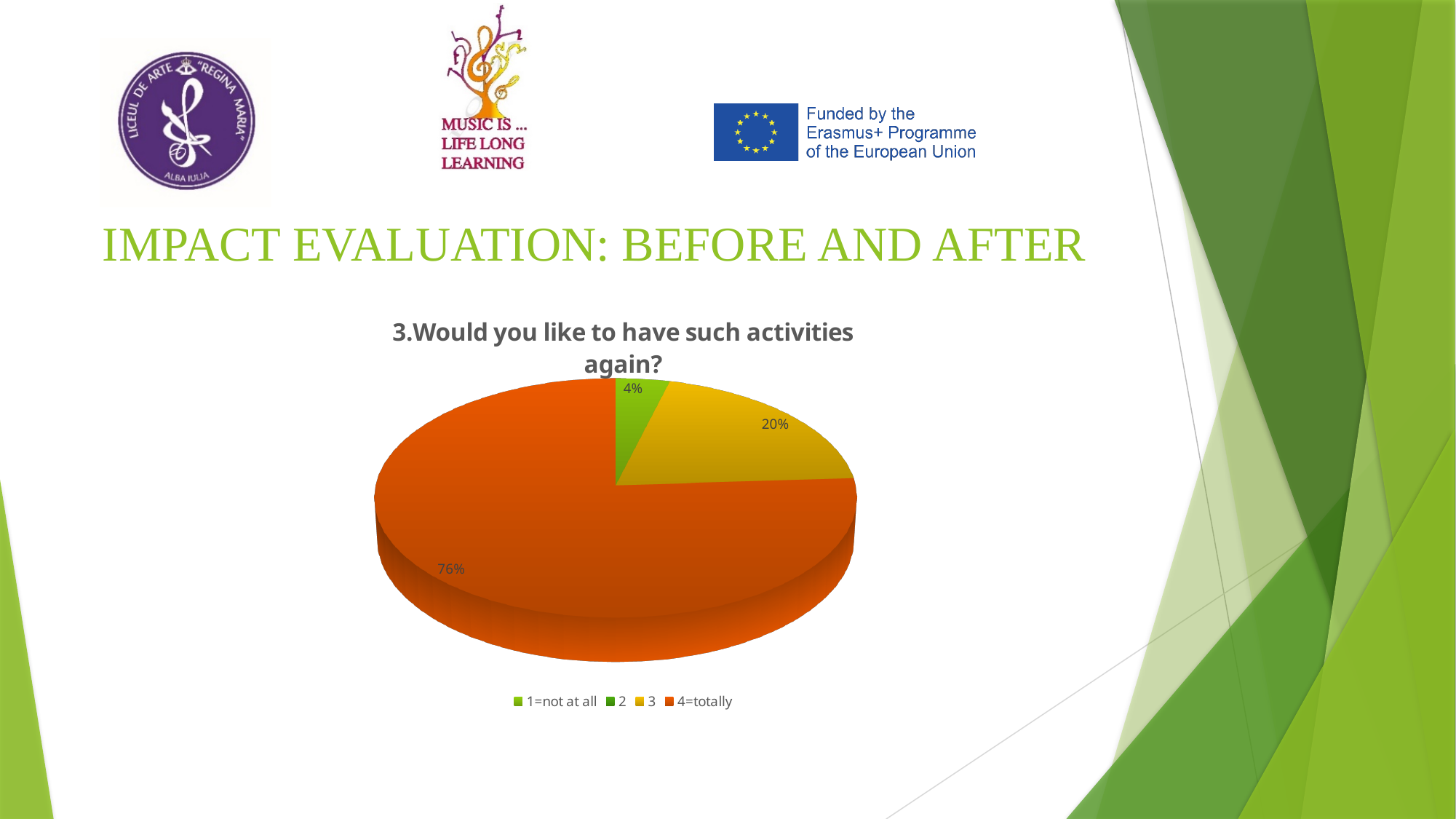
What colour is the '4=totally' slice? orange What percentage of the pie is labelled for the '3' slice? 20% Which is larger, the share for '3' or the share for '4=totally'? 4=totally What percentage of the pie is labelled for the '4=totally' slice? 76% What type of chart is shown on the slide? pie chart What is the smallest percentage labelled on the pie? 4% What is the title of the chart? 3.Would you like to have such activities again? What is the combined share of the '3' and '4=totally' slices? 96% How many slices with percentage labels are visible on the pie? 3 What is the difference between the '4=totally' share and the '3' share? 56% How many entries does the legend list? 4 Which category has the largest share of the pie? 4=totally